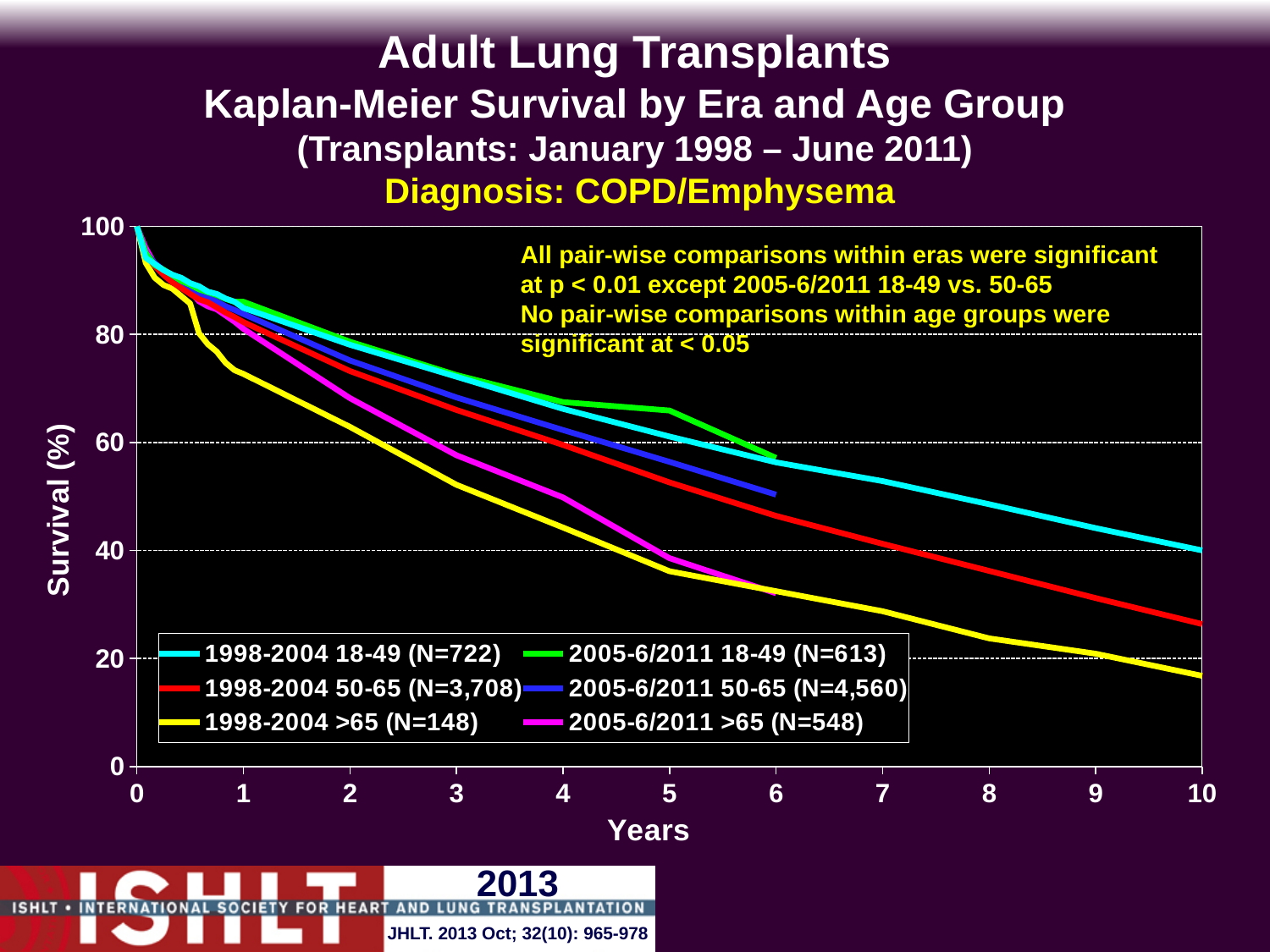
Which series has the lowest survival at year 10? 1998-2004 >65 (N=148) Is the survival value for 2005-6/2011 50-65 at year 6 greater or less than 60? less Do the survival curves rise or fall as years increase? fall Is the survival value for 1998-2004 >65 at year 10 greater or less than 20? less Is the survival value for 1998-2004 >65 at year 1 greater or less than 80? less What kind of chart is shown on the slide? line chart How many series does the legend list? 6 What is the N for the 1998-2004 50-65 group shown in the legend? 3,708 What is the N for the 2005-6/2011 >65 group shown in the legend? 548 At year 5, which has higher survival: 1998-2004 18-49 or 1998-2004 >65? 1998-2004 18-49